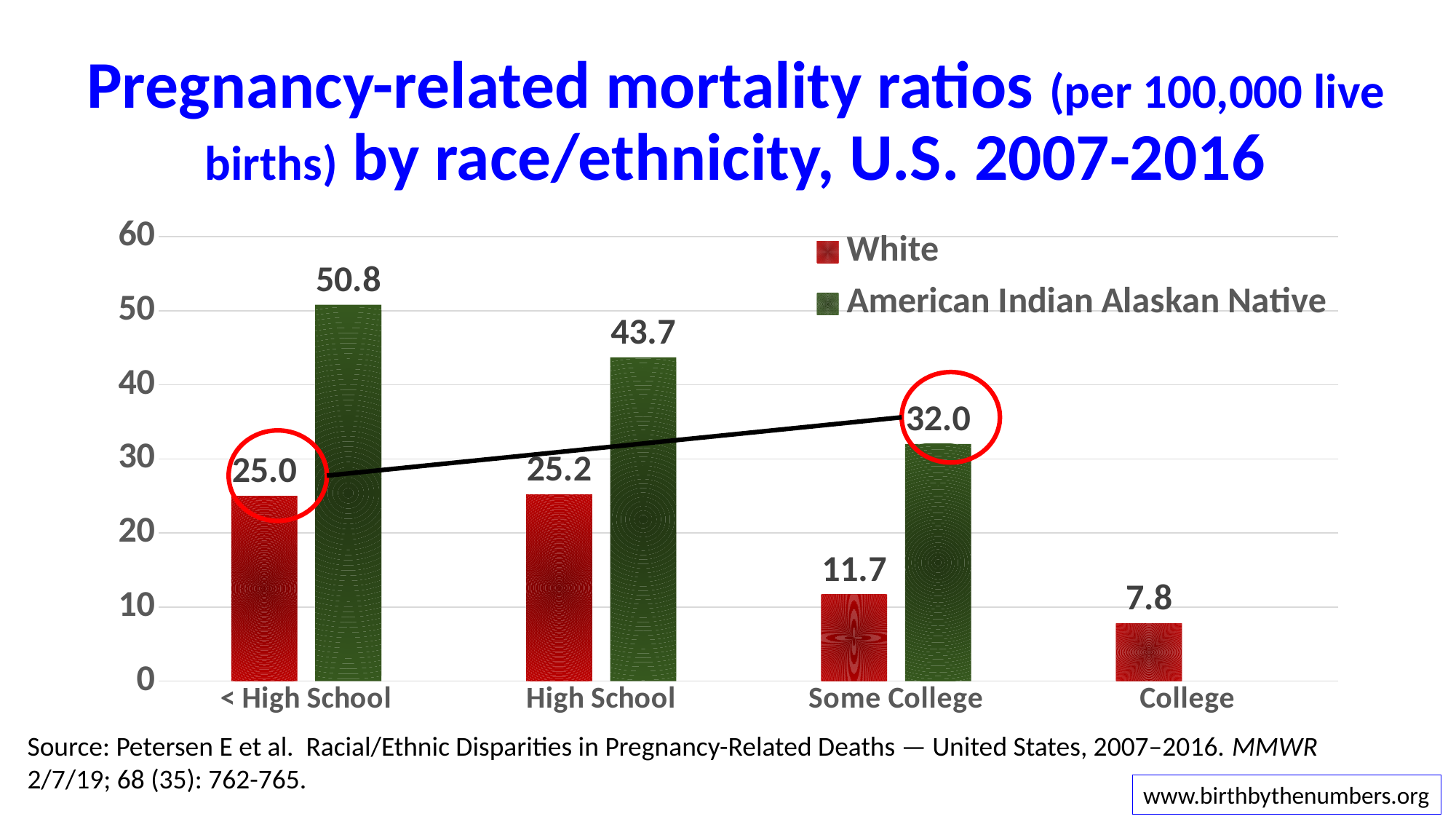
Which education category has the highest value for American Indian Alaskan Native women? < High School Which is larger in the Some College category: the White value or the American Indian Alaskan Native value? American Indian Alaskan Native What kind of chart is shown on the slide? Bar chart What is the pregnancy-related mortality ratio for American Indian Alaskan Native women with a high school education? 43.7 Which education category has the lowest value for White women? College How many series does the legend list? 2 How many education categories are shown on the x axis? 4 What is the value for White women in the College category? 7.8 What is the pregnancy-related mortality ratio for White women with less than a high school education? 25.0 Which colour represents the White series in the chart? Red What is the difference between the American Indian Alaskan Native and White values in the < High School category? 25.8 What is the difference between the American Indian Alaskan Native and White values in the Some College category? 20.3